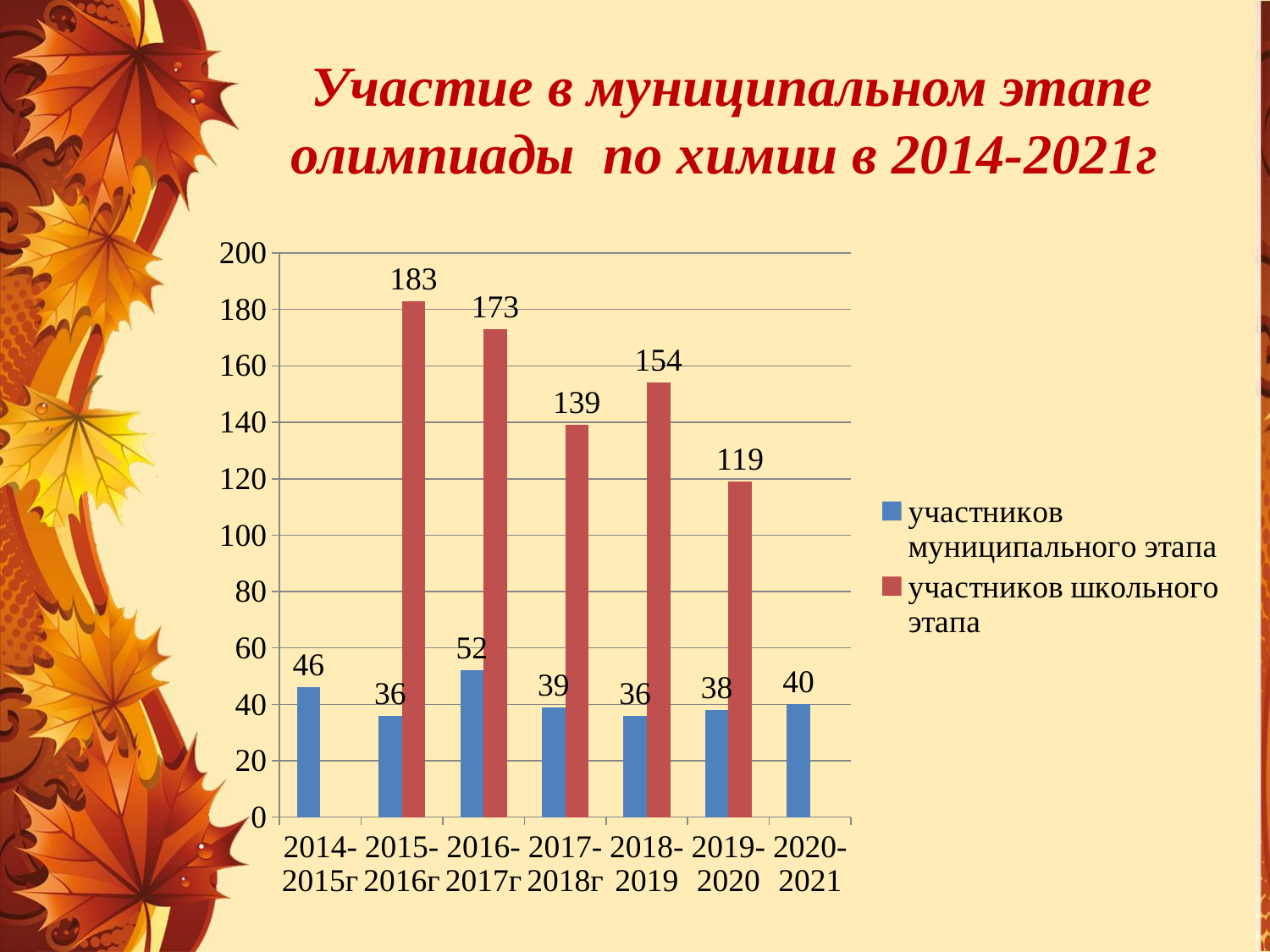
What is the difference between the school stage participants in 2015-2016г and 2016-2017г? 10 Which is larger: the school stage participants in 2017-2018г or in 2018-2019? 2018-2019 How many year categories are shown on the x axis? 7 What is the difference between the municipal stage participants in 2014-2015г and 2015-2016г? 10 Which year has the highest number of participants of the municipal stage (участников муниципального этапа)? 2016-2017г Which year has the highest number of participants of the school stage (участников школьного этапа)? 2015-2016г Which year has the lowest number of participants of the school stage (участников школьного этапа) among the years where it is shown? 2019-2020 How many participants of the municipal stage (участников муниципального этапа) were there in 2016-2017г? 52 How many participants of the school stage (участников школьного этапа) were there in 2015-2016г? 183 What is the value for участников школьного этапа in 2019-2020? 119 How many series does the legend list? 2 What kind of chart is shown on the slide? Bar chart